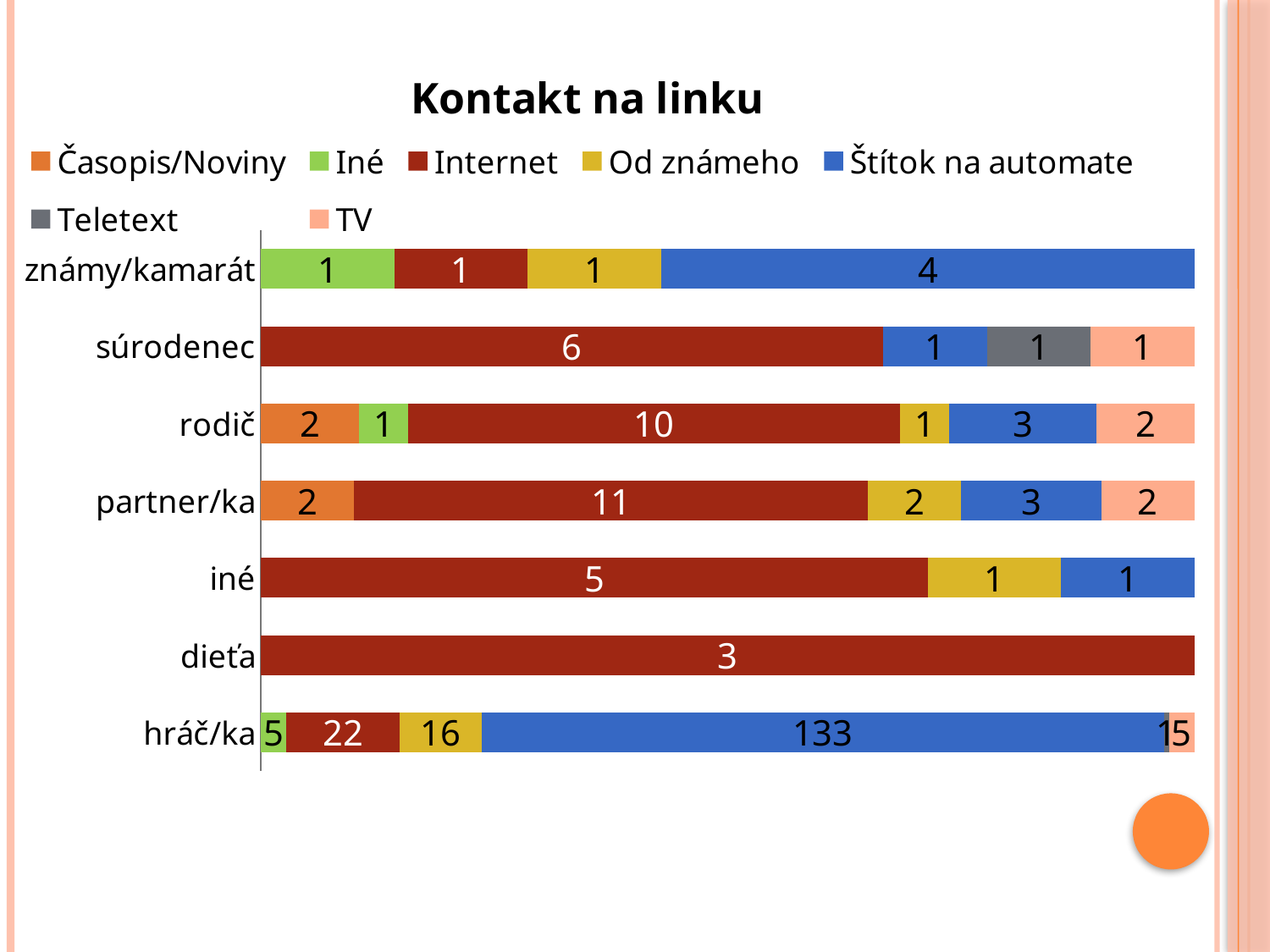
What is the value of Od známeho for hráč/ka? 16 What is the total of the stacked bar for partner/ka? 20 How many series does the legend list? 7 What is the value of Internet for partner/ka? 11 Which is larger, the Internet value for súrodenec or the Internet value for iné? súrodenec What is the total of the stacked bar for rodič? 19 What is the value of Štítok na automate for hráč/ka? 133 What is the value of Internet for rodič? 10 What is the title of the chart? Kontakt na linku How many categories are shown on the vertical axis? 7 What type of chart is shown on the slide? stacked bar chart What is the difference between the Internet values for hráč/ka and partner/ka? 11